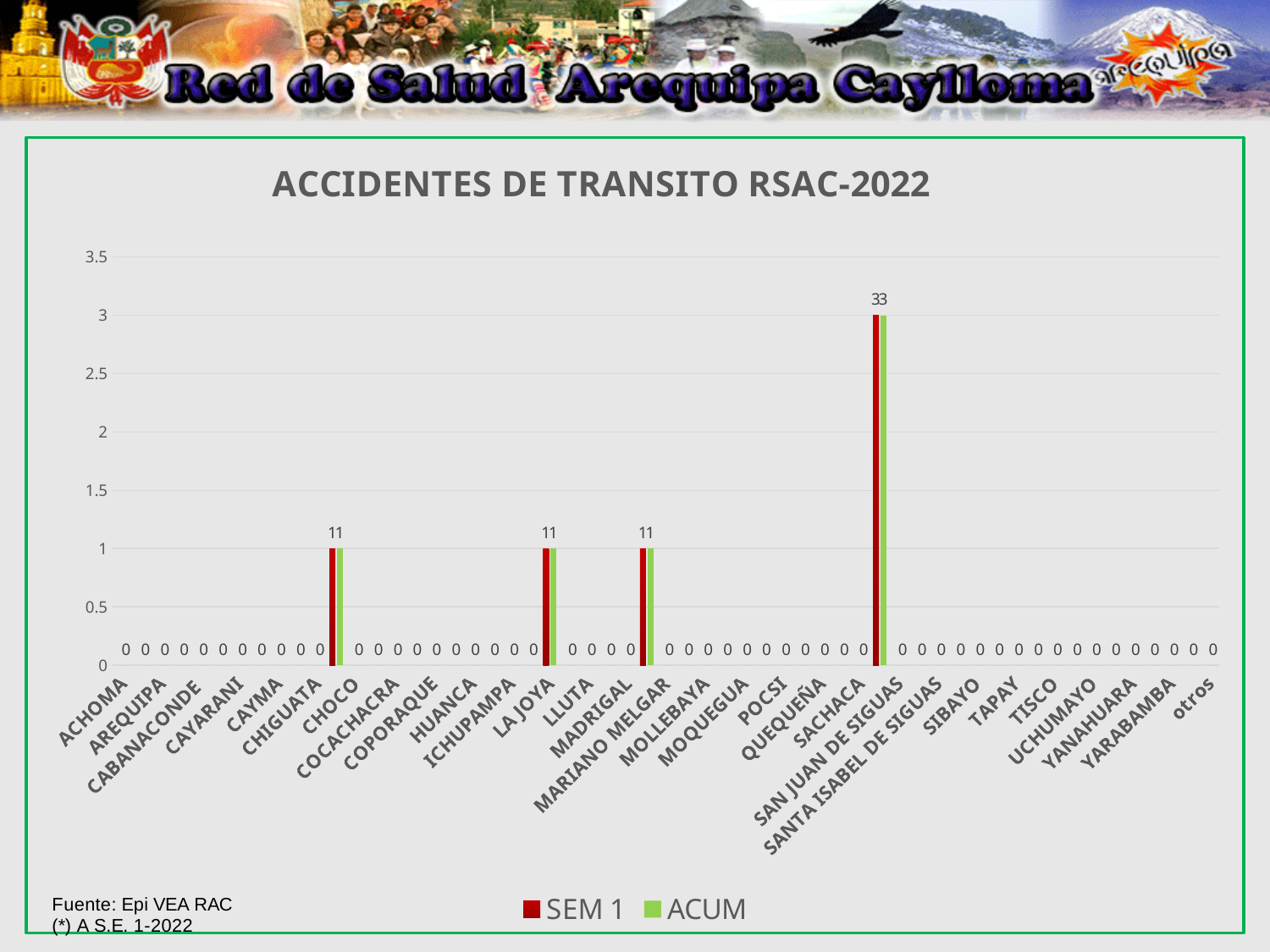
What is the title of the chart? ACCIDENTES DE TRANSITO RSAC-2022 What is the ACUM value for AREQUIPA? 0 What are the two series named in the legend? SEM 1 and ACUM What kind of chart is shown on the slide? bar chart How many series does the legend list? 2 What is the ACUM value for LA JOYA? 1 How many categories are shown on the x axis? 29